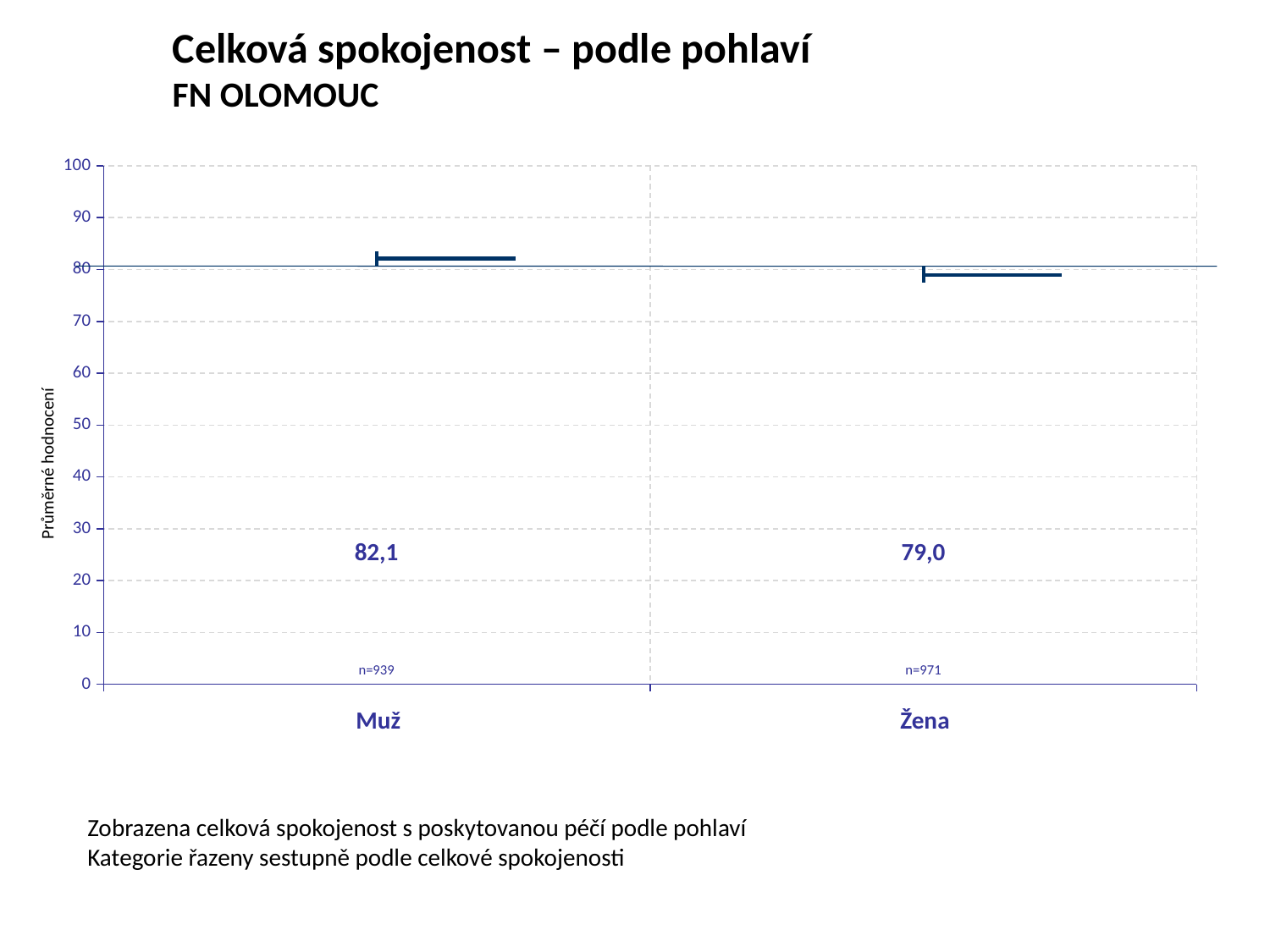
Is the value for Žena greater or less than 80? less What is the difference between the average rating for Muž and for Žena? 3,1 How many categories are shown on the x axis of the chart? 2 Is the value for Muž greater or less than 80? greater Which category has the highest average rating? Muž What is the average rating (Průměrné hodnocení) for Muž? 82,1 What is the average rating (Průměrné hodnocení) for Žena? 79,0 Which category has the higher average rating, Muž or Žena? Muž What is the sample size (n) shown for the Žena category? n=971 What is the sample size (n) shown for the Muž category? n=939 What is the label of the vertical axis of the chart? Průměrné hodnocení Which category has the lowest average rating? Žena